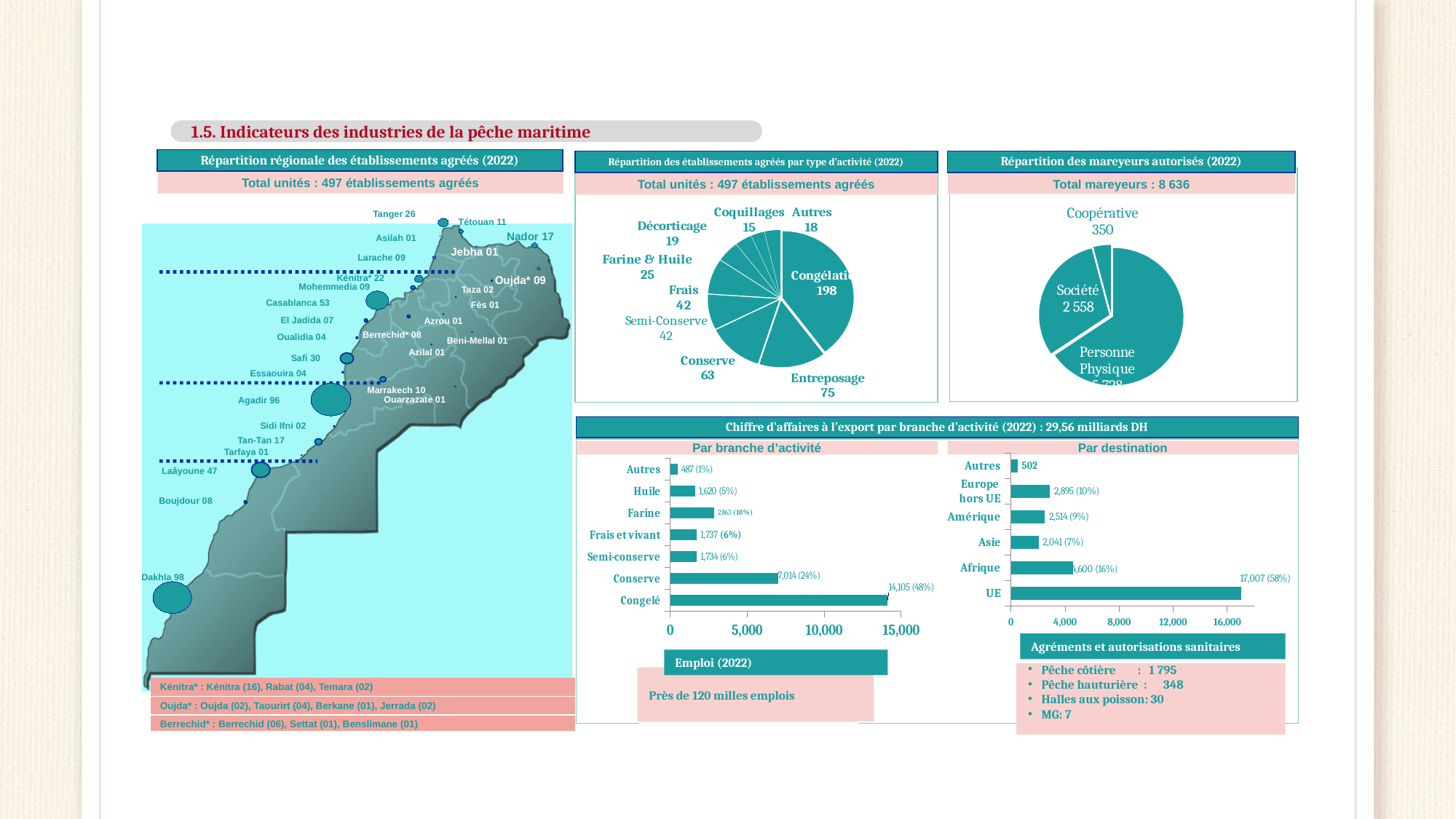
In the pie chart 'Répartition des établissements agréés par type d'activité (2022)', how many establishments are in the Congélation category? 198 In the 'Par branche d'activité' bar chart, what is the value for Conserve? 7,014 In the 'Par destination' bar chart, what is the value for UE? 17,007 In the 'Par branche d'activité' bar chart, which branch has the highest value? Congelé In the pie chart 'Répartition des établissements agréés par type d'activité (2022)', which activity type has the smallest number of establishments? Coquillages In the 'Par destination' bar chart, which is larger, the value for Afrique or the value for Asie? Afrique How many destination categories are shown in the 'Par destination' bar chart? 6 In the 'Par destination' bar chart, what percentage share is shown for UE? 58% How many activity categories are shown in the pie chart 'Répartition des établissements agréés par type d'activité (2022)'? 9 In the 'Par branche d'activité' bar chart, what is the difference between the values for Congelé and Conserve? 7,091 In the pie chart 'Répartition des mareyeurs autorisés (2022)', what is the value for Société? 2 558 In the pie chart 'Répartition des établissements agréés par type d'activité (2022)', which activity type has the largest number of establishments? Congélation